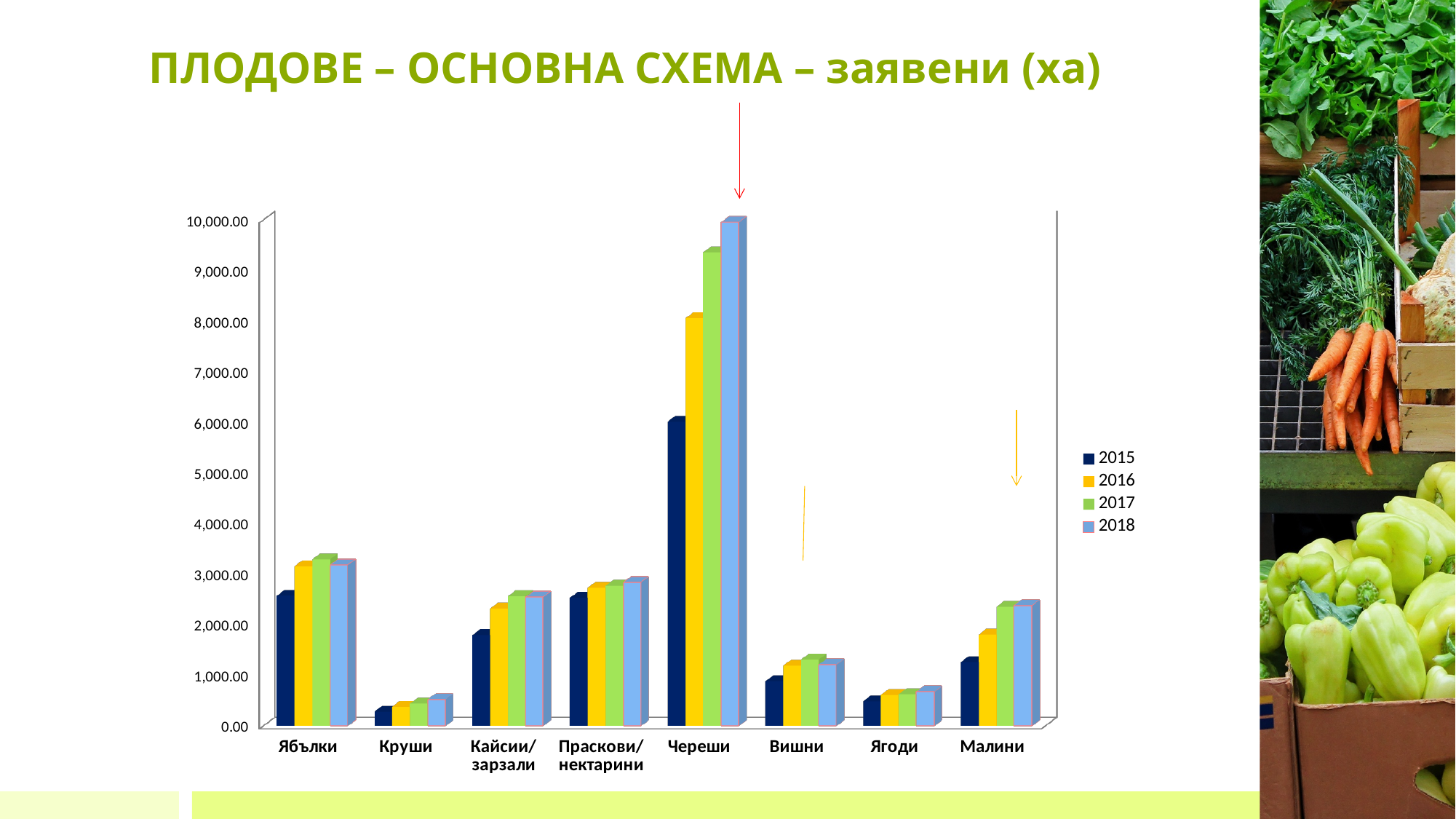
Which is larger for Череши: the 2015 value or the 2018 value? 2018 Which category has the lowest value for 2015? Круши Is the 2018 value for Малини greater or less than 2,000.00? greater How many fruit categories are shown on the x axis of the chart? 8 Is the 2018 value for Череши greater or less than 9,000.00? greater Is the 2015 value for Вишни greater or less than 1,000.00? less Which category has the highest value for 2018? Череши What is the title of the slide's chart? ПЛОДОВЕ – ОСНОВНА СХЕМА – заявени (ха) How many series does the chart's legend list? 4 What kind of chart is shown on the slide? Bar chart Do the values for Череши rise or fall from 2015 to 2018? Rise Which category has the larger 2018 value: Ягоди or Малини? Малини